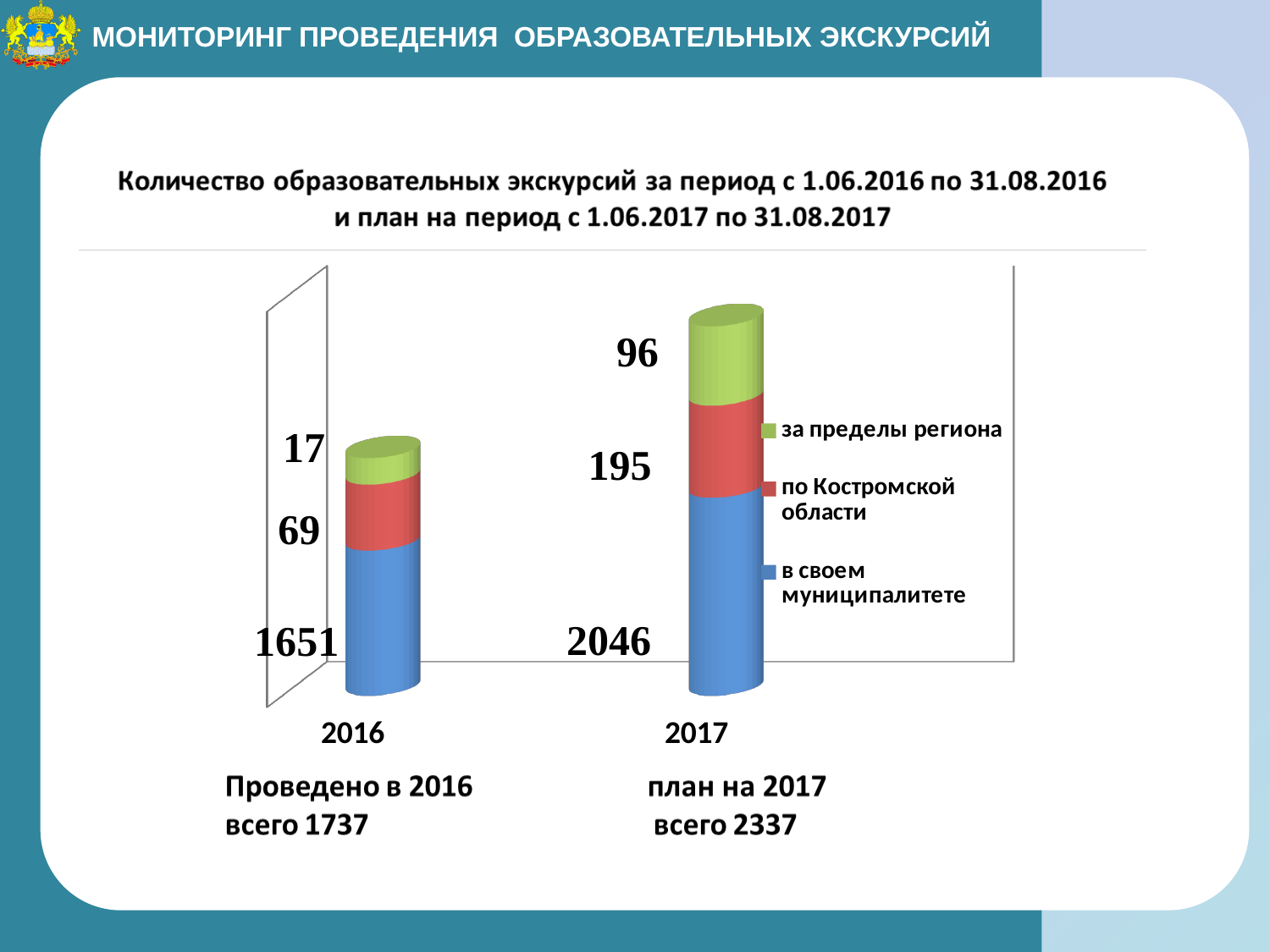
What is the value for "за пределы региона" in 2016? 17 What is the total of the stacked bar for 2017? 2337 What is the value for "по Костромской области" in 2017? 195 How many series does the legend list? 3 What is the value for "за пределы региона" in 2017? 96 How many categories are shown on the x axis? 2 Which is larger: the "по Костромской области" value for 2016 or for 2017? 2017 What is the value for "в своем муниципалитете" in 2016? 1651 What type of chart is shown on the slide? stacked bar chart What is the total of the stacked bar for 2016? 1737 What is the difference between the "в своем муниципалитете" values for 2017 and 2016? 395 Which series is shown in green in the legend? за пределы региона